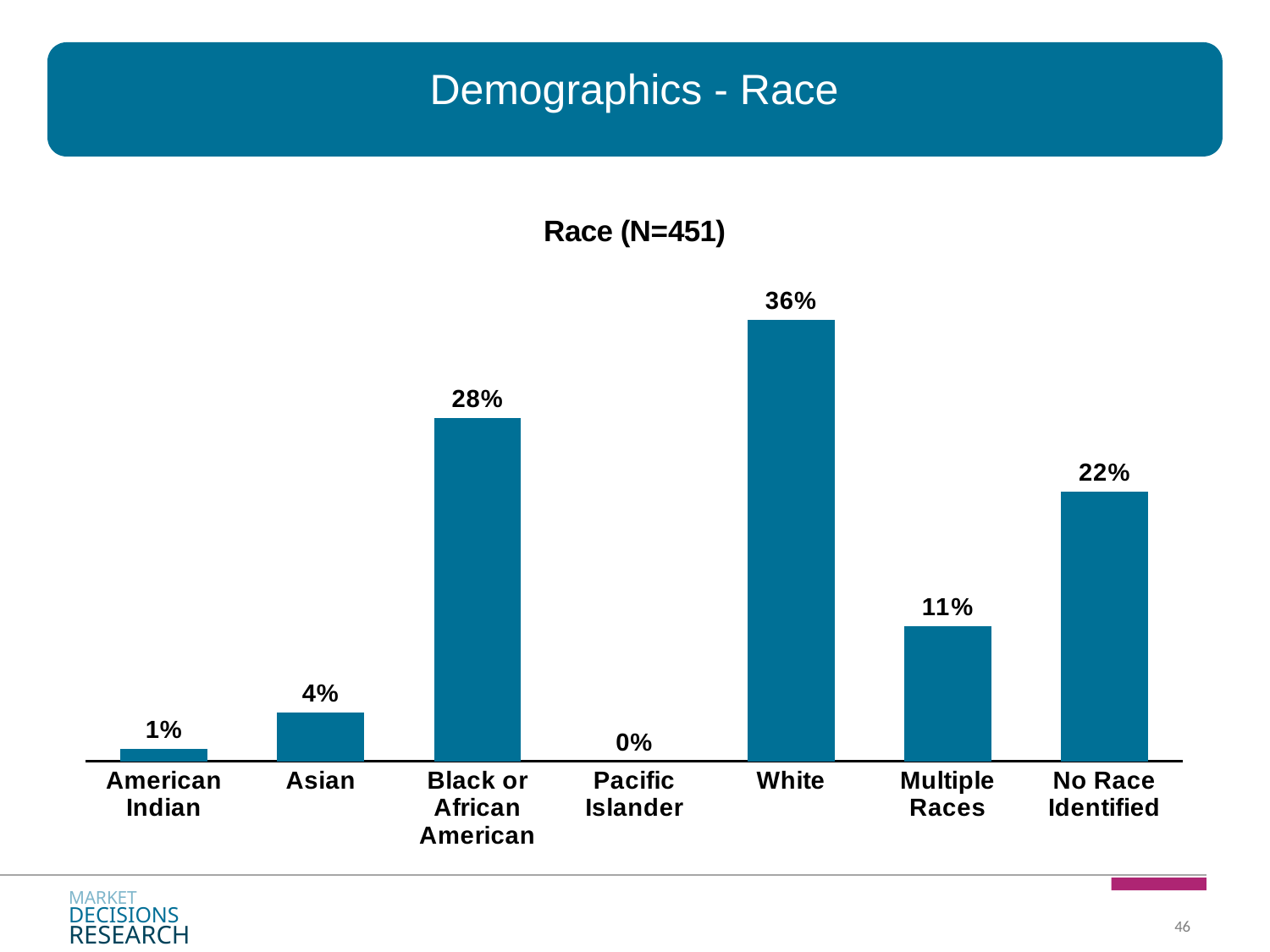
What percentage of respondents had No Race Identified? 22% What percentage of respondents are Asian? 4% Which race category has the highest percentage? White What is the title of the chart? Race (N=451) What is the sample size (N) shown in the chart title? 451 How many race categories are shown on the chart? 7 What percentage of respondents are Black or African American? 28% What is the difference in percentage points between White and Black or African American? 8% Which is larger, the percentage for Multiple Races or for No Race Identified? No Race Identified What kind of chart is shown on the slide? Bar chart What percentage of respondents are White? 36% Which race category has the lowest percentage? Pacific Islander